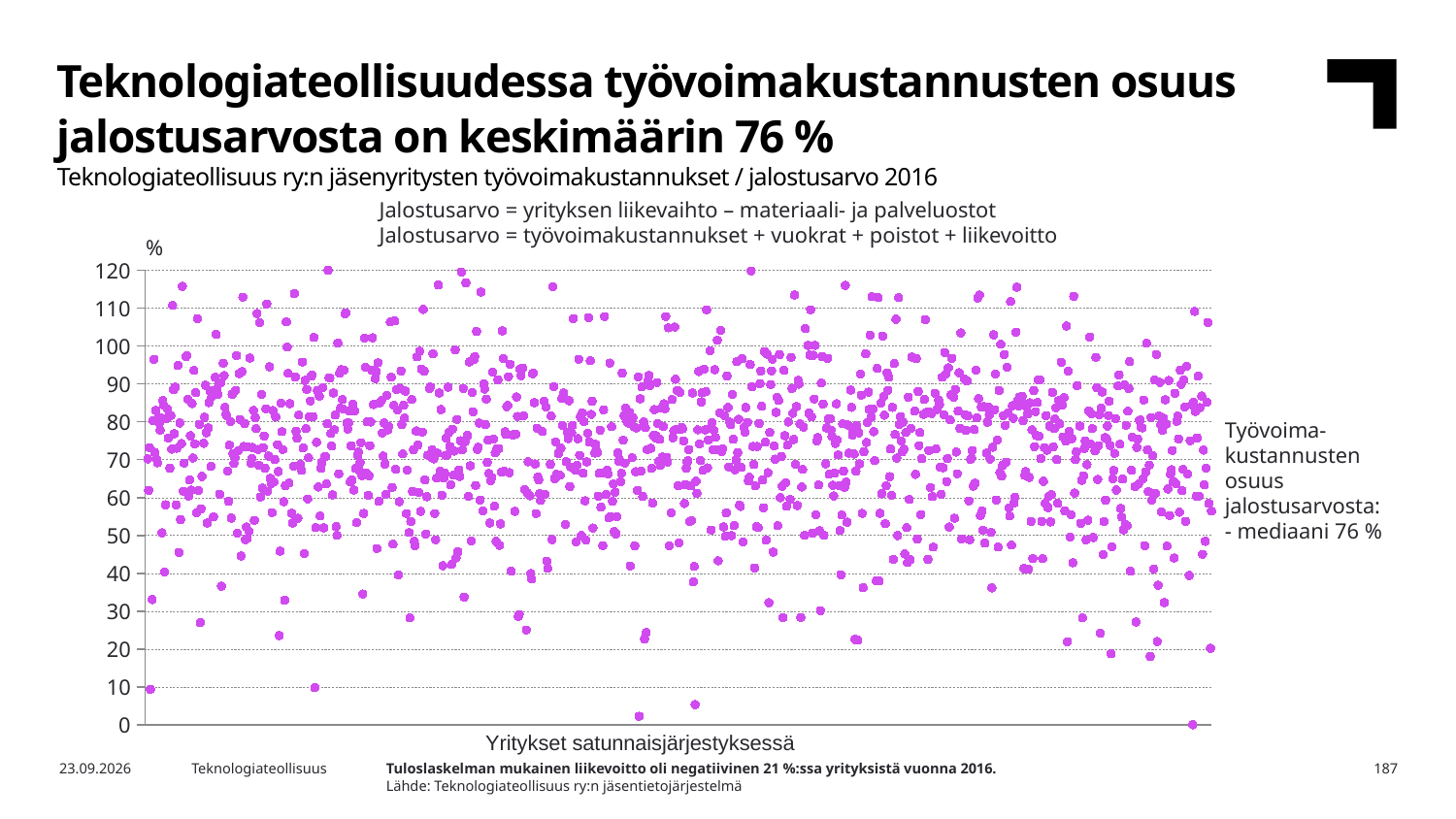
According to the annotation on the chart, what is the median share of labour costs in value added (työvoimakustannusten osuus jalostusarvosta)? 76 % What kind of chart is shown on the slide? scatter chart What is the label of the x axis of the chart? Yritykset satunnaisjärjestyksessä What is the highest value shown on the y axis of the chart? 120